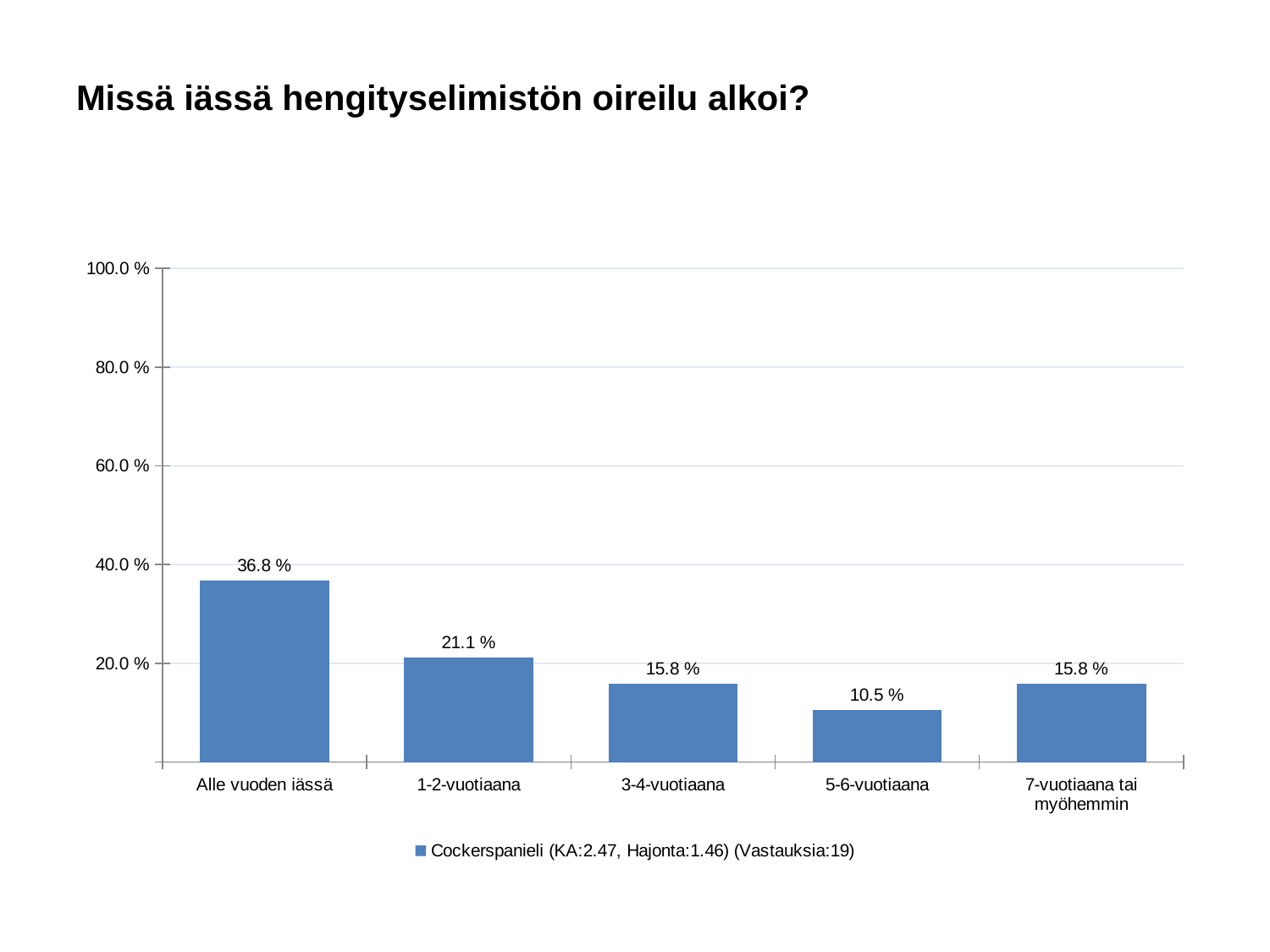
What is the value for "Alle vuoden iässä"? 36.8 % Which category has the highest value? Alle vuoden iässä What is the difference between the values for "Alle vuoden iässä" and "1-2-vuotiaana"? 15.7 % What kind of chart is shown on the slide? bar chart Is the value for "Alle vuoden iässä" greater or less than 20.0 %? greater What is the title of the slide? Missä iässä hengityselimistön oireilu alkoi? How many series does the legend list? 1 Which category has the lowest value? 5-6-vuotiaana What is the value for "5-6-vuotiaana"? 10.5 % Which is larger, the value for "1-2-vuotiaana" or the value for "3-4-vuotiaana"? 1-2-vuotiaana How many categories are shown on the x axis? 5 What is the value for "1-2-vuotiaana"? 21.1 %